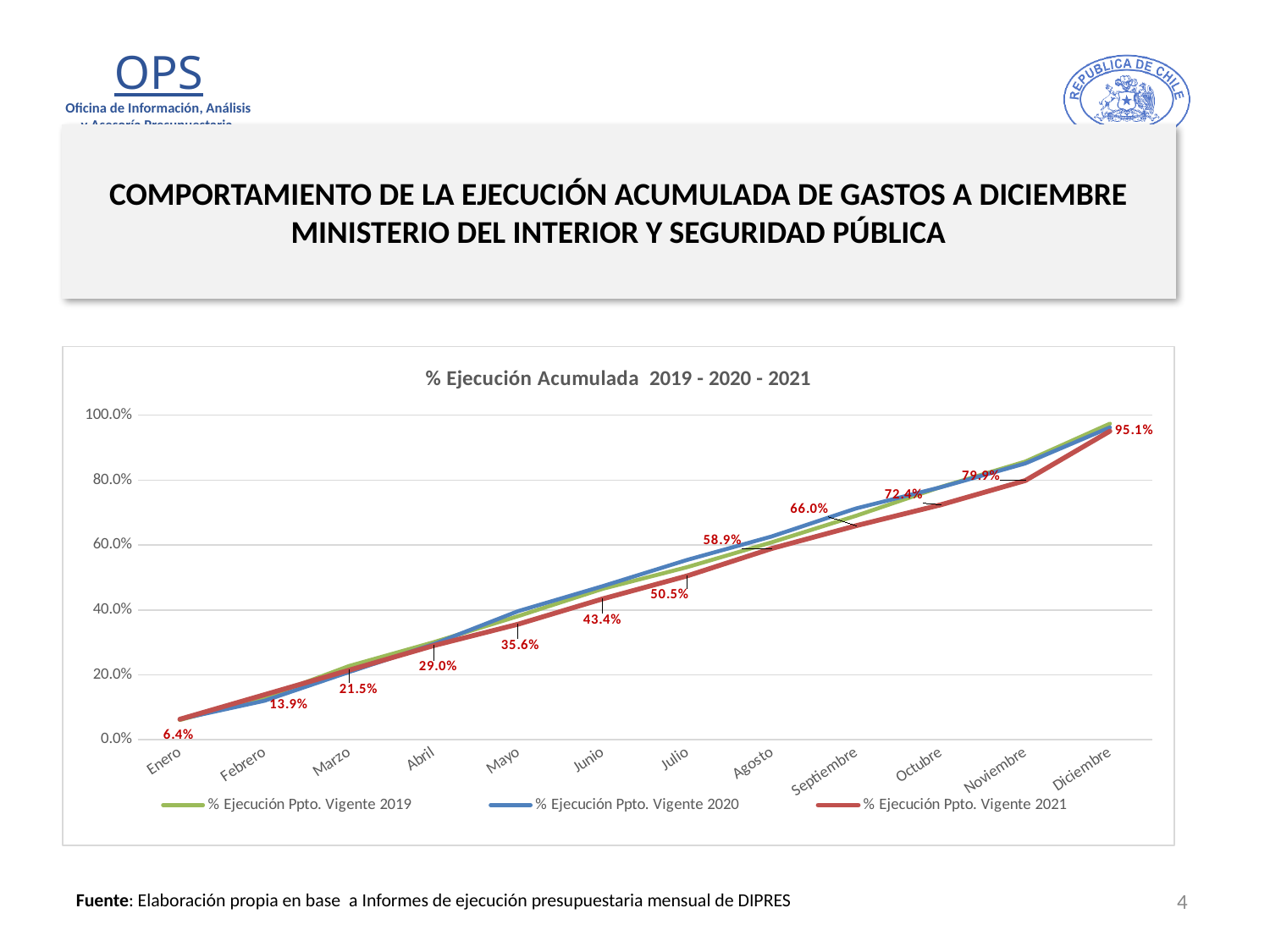
How many series does the legend list? 3 Do the values of the % Ejecución Ppto. Vigente 2021 series rise or fall from Enero to Diciembre? rise What type of chart is shown on the slide? line chart What is the difference between the % Ejecución Ppto. Vigente 2021 values for Agosto and Julio? 8.4% What is the value for % Ejecución Ppto. Vigente 2021 in Diciembre? 95.1% Is the value for % Ejecución Ppto. Vigente 2020 in Diciembre greater or less than 80.0%? greater What is the value for % Ejecución Ppto. Vigente 2021 in Septiembre? 66.0% What is the title of the chart? % Ejecución Acumulada 2019 - 2020 - 2021 What is the value for % Ejecución Ppto. Vigente 2021 in Junio? 43.4% In which month is the % Ejecución Ppto. Vigente 2021 value lowest? Enero What is the value for % Ejecución Ppto. Vigente 2021 in Enero? 6.4% How many months are plotted along the x axis? 12